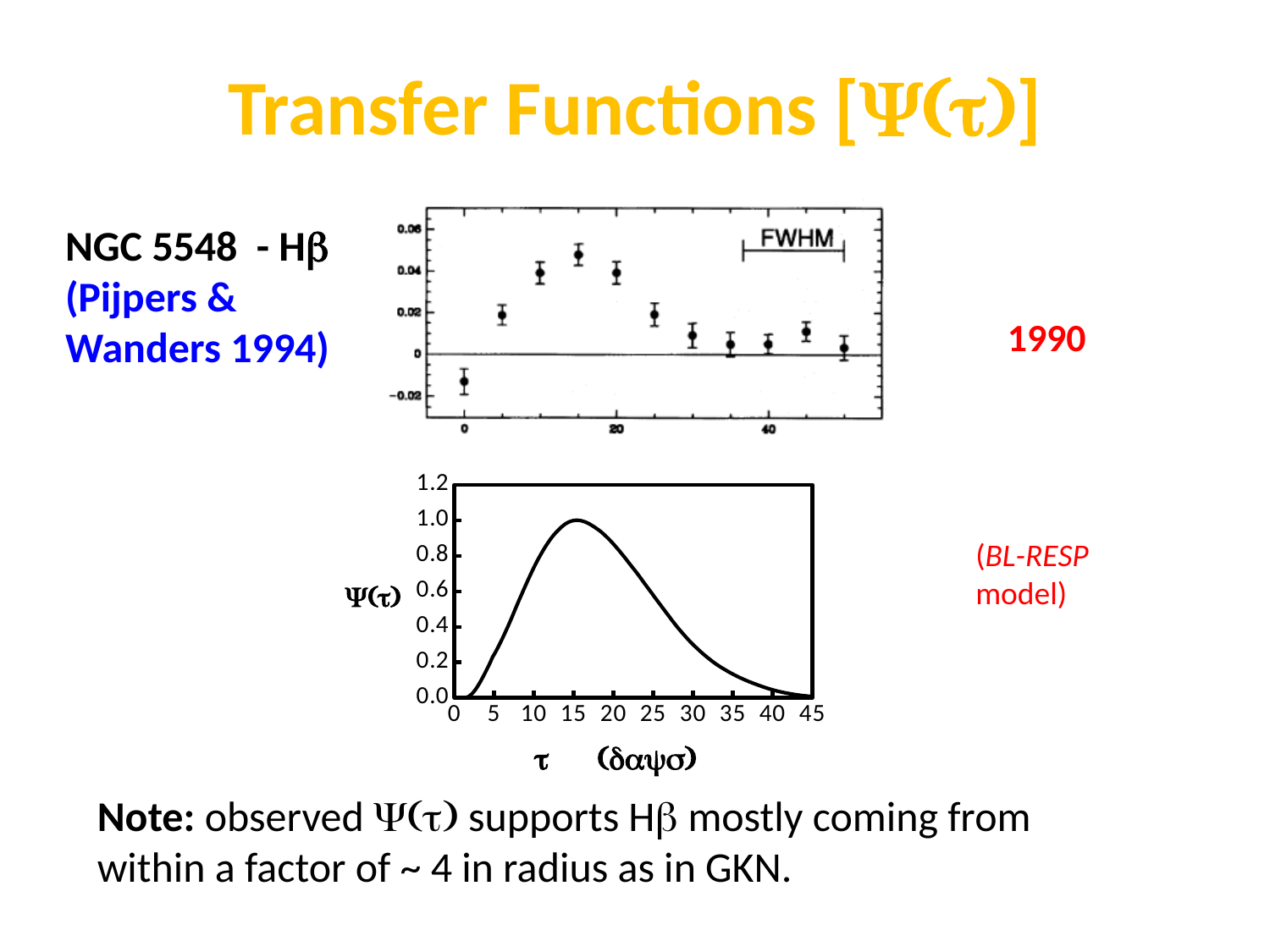
In the lower chart (BL-RESP model), which is larger: Ψ(τ) at τ = 10 or at τ = 35? τ = 10 In the upper chart (NGC 5548 - Hβ), what label is written above the horizontal bar in the top right of the plot? FWHM In the lower chart (BL-RESP model), is the value of Ψ(τ) at τ = 40 greater or less than 0.2? less In the upper chart (NGC 5548 - Hβ), is the value of the point at τ = 0 greater or less than 0? less In the lower chart (BL-RESP model), is the value of Ψ(τ) at τ = 15 greater or less than 0.8? greater In the lower chart (BL-RESP model), what is the label on the y axis? Ψ(τ) In the lower chart (BL-RESP model), what is the maximum value of Ψ(τ) reached by the curve? 1.0 In the upper chart (NGC 5548 - Hβ, Pijpers & Wanders 1994), how many data points are plotted? 11 What kind of chart is the lower chart (the BL-RESP model)? line chart In the lower chart (BL-RESP model), does Ψ(τ) rise or fall as τ increases from 20 to 45? fall